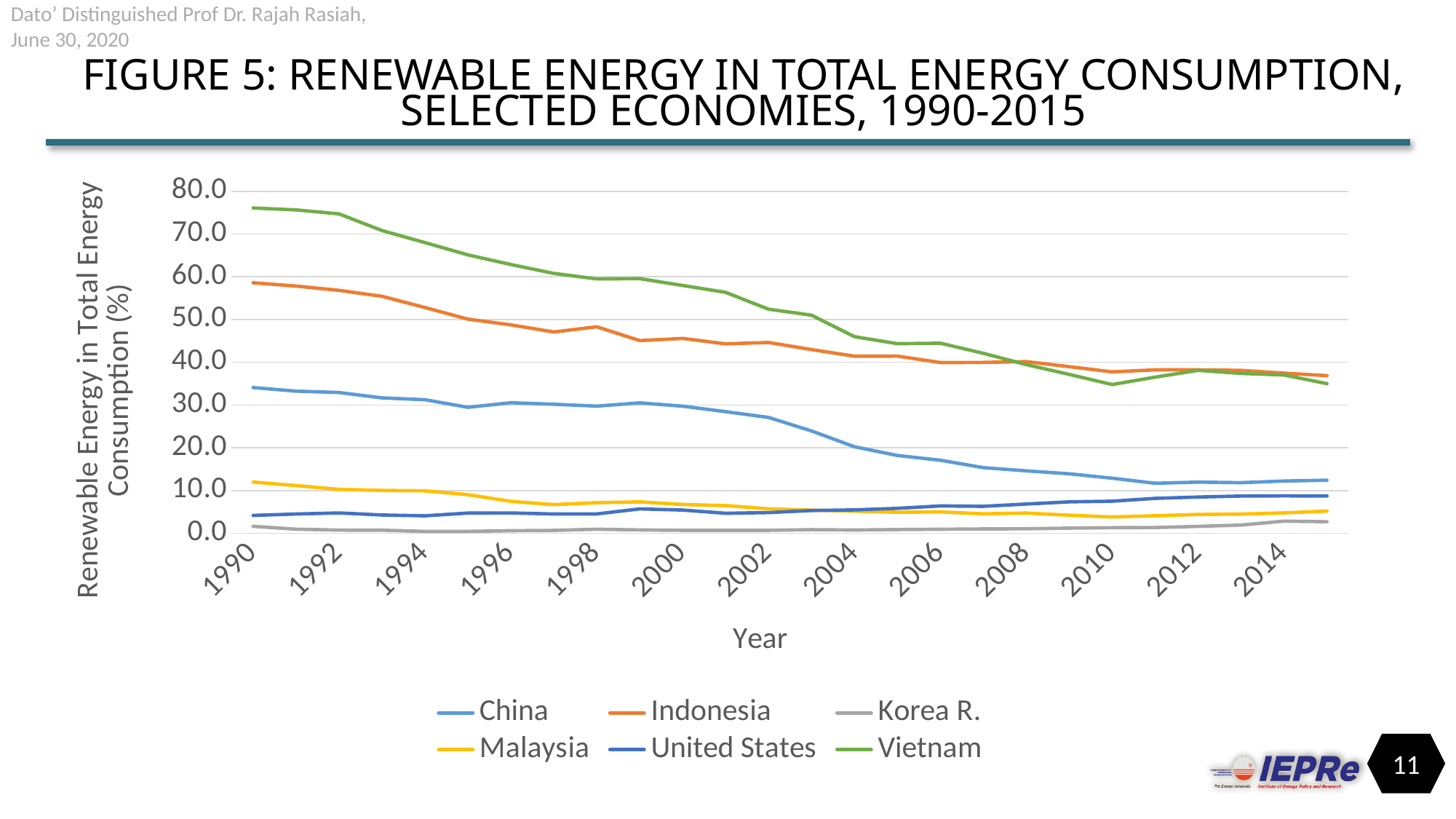
Does the renewable energy share for China rise or fall over the period shown? Fall What is the label of the y axis? Renewable Energy in Total Energy Consumption (%) How many series does the legend list? 6 Is the value for Indonesia in 1990 greater or less than 50.0? greater Does the renewable energy share for Vietnam rise or fall from 1990 to 2015? Fall Is the value for the United States in 2014 greater or less than 10.0? less Which economy has the highest share of renewable energy in total energy consumption in 1990? Vietnam In 1990, which is larger: the value for Vietnam or the value for Indonesia? Vietnam What kind of chart is shown on the slide? Line chart Is the value for Vietnam in 1990 greater or less than 70.0? greater Which economy has the lowest share of renewable energy in total energy consumption across the period shown? Korea R. In 1990, which is larger: the value for China or the value for Malaysia? China